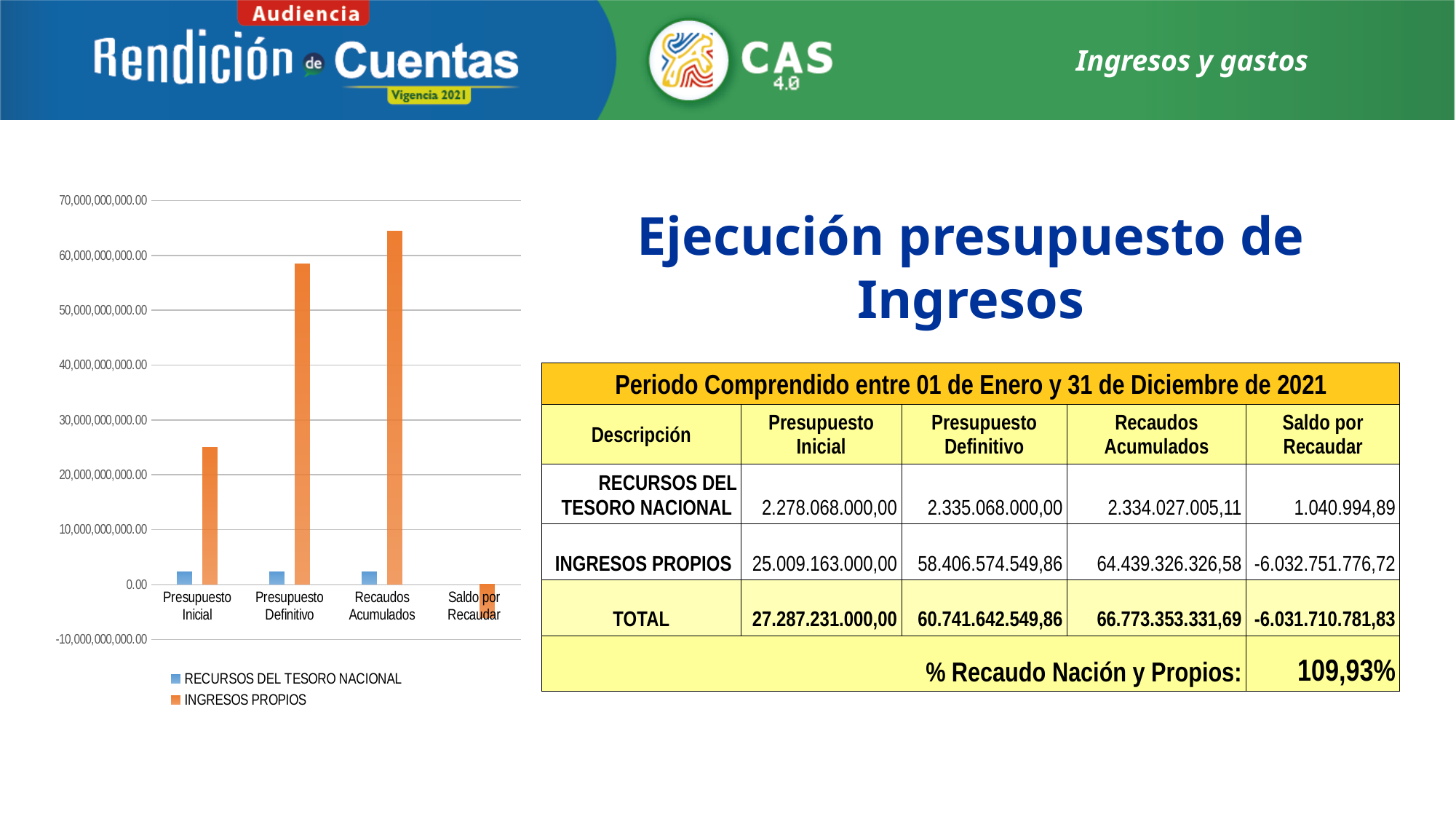
How many categories are shown on the x axis of the bar chart? 4 In the bar chart, is the INGRESOS PROPIOS value for Presupuesto Definitivo greater or less than 50,000,000,000.00? greater In the bar chart, for which category is the INGRESOS PROPIOS bar the lowest? Saldo por Recaudar How many series does the legend of the bar chart list? 2 In the bar chart, is the INGRESOS PROPIOS value for Presupuesto Inicial greater or less than 30,000,000,000.00? less What kind of chart is shown on the left of the slide? bar chart In the bar chart, is the RECURSOS DEL TESORO NACIONAL value for Presupuesto Inicial greater or less than 10,000,000,000.00? less In the bar chart, which INGRESOS PROPIOS bar is taller: Presupuesto Definitivo or Recaudos Acumulados? Recaudos Acumulados What colour are the INGRESOS PROPIOS bars in the chart? orange In the bar chart, for which category is the INGRESOS PROPIOS bar the tallest? Recaudos Acumulados In the bar chart, which series has the taller bar for Presupuesto Inicial? INGRESOS PROPIOS